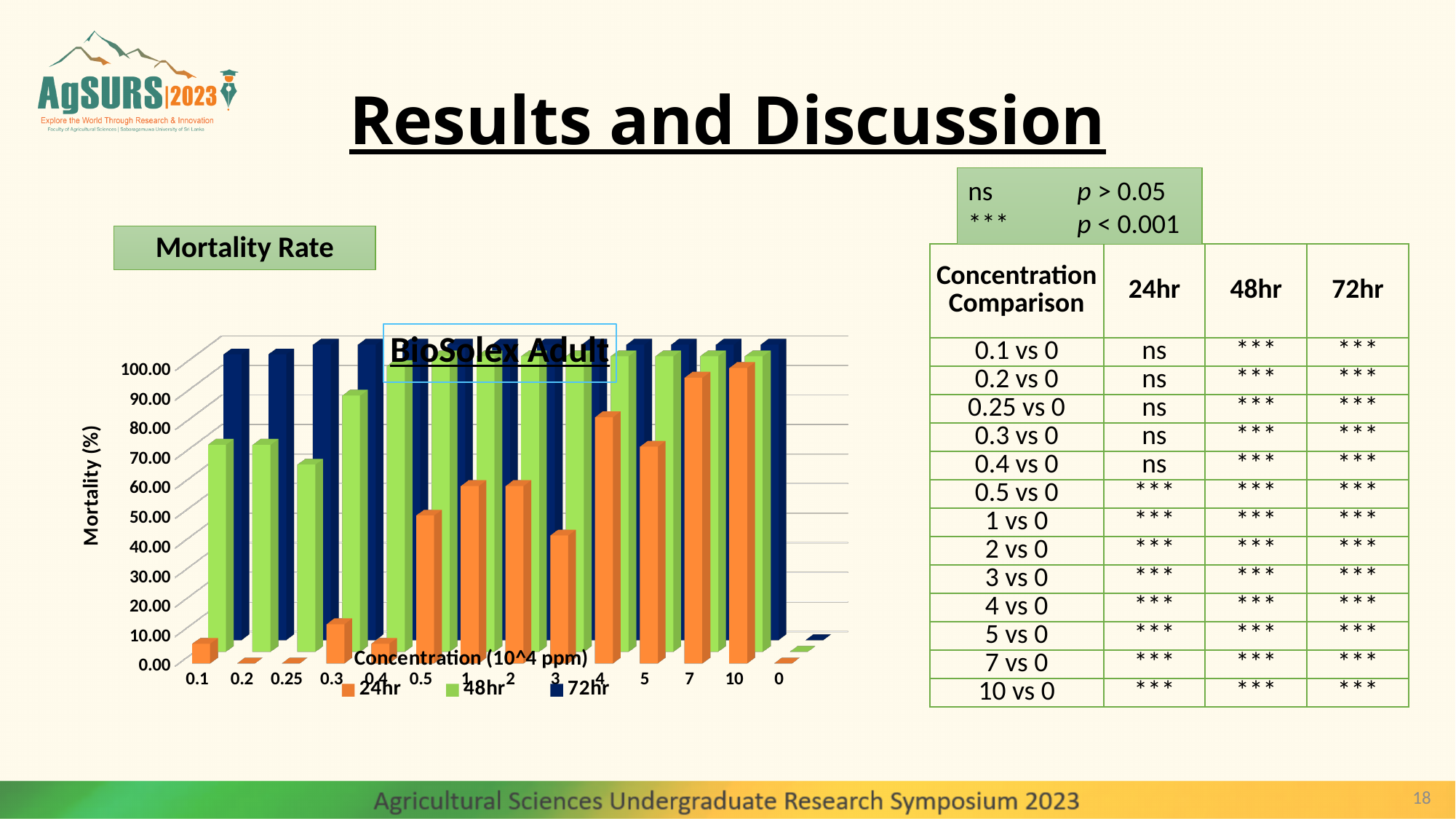
Is the 48hr mortality value at concentration 0.25 greater or less than 50? greater What is the title of the chart? BioSolex Adult Is the 24hr mortality value at concentration 10 greater or less than 90? greater How many concentration categories are shown on the x axis of the chart? 14 What kind of chart is shown on the slide? bar chart Is the 24hr mortality value at concentration 0.3 greater or less than 30? less How many series does the chart legend list? 3 What is the label of the vertical axis of the chart? Mortality (%) At concentration 0.1, which series has the lowest mortality? 24hr At concentration 0.1, which series has the higher mortality: 24hr or 48hr? 48hr